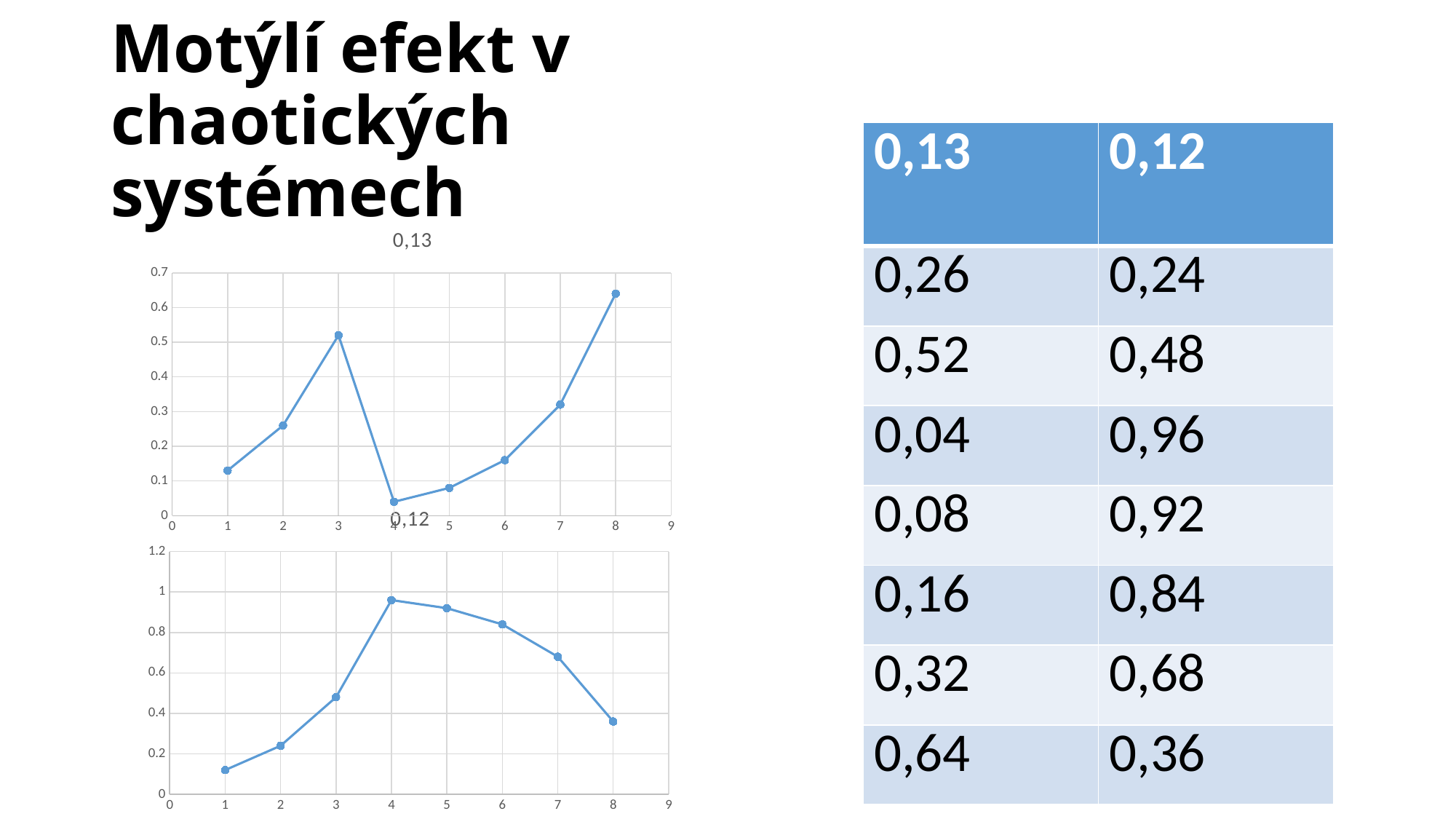
What kind of chart is the top chart titled "0,13"? line chart In the top chart titled "0,13", at which x value is the plotted value lowest? 4 In the bottom chart titled "0,12", is the value at x = 4 greater or less than 0.8? greater In the top chart titled "0,13", is the value at x = 4 greater or less than 0.1? less In the bottom chart titled "0,12", do the values rise or fall from x = 4 to x = 8? fall In the top chart titled "0,13", at which x value is the plotted value highest? 8 How many data points are plotted in the top chart titled "0,13"? 8 In the bottom chart titled "0,12", at which x value is the plotted value lowest? 1 How many data points are plotted in the bottom chart titled "0,12"? 8 In the bottom chart titled "0,12", at which x value is the plotted value highest? 4 In the top chart titled "0,13", which is larger, the value at x = 3 or the value at x = 7? x = 3 In the bottom chart titled "0,12", is the value at x = 8 greater or less than 0.4? less